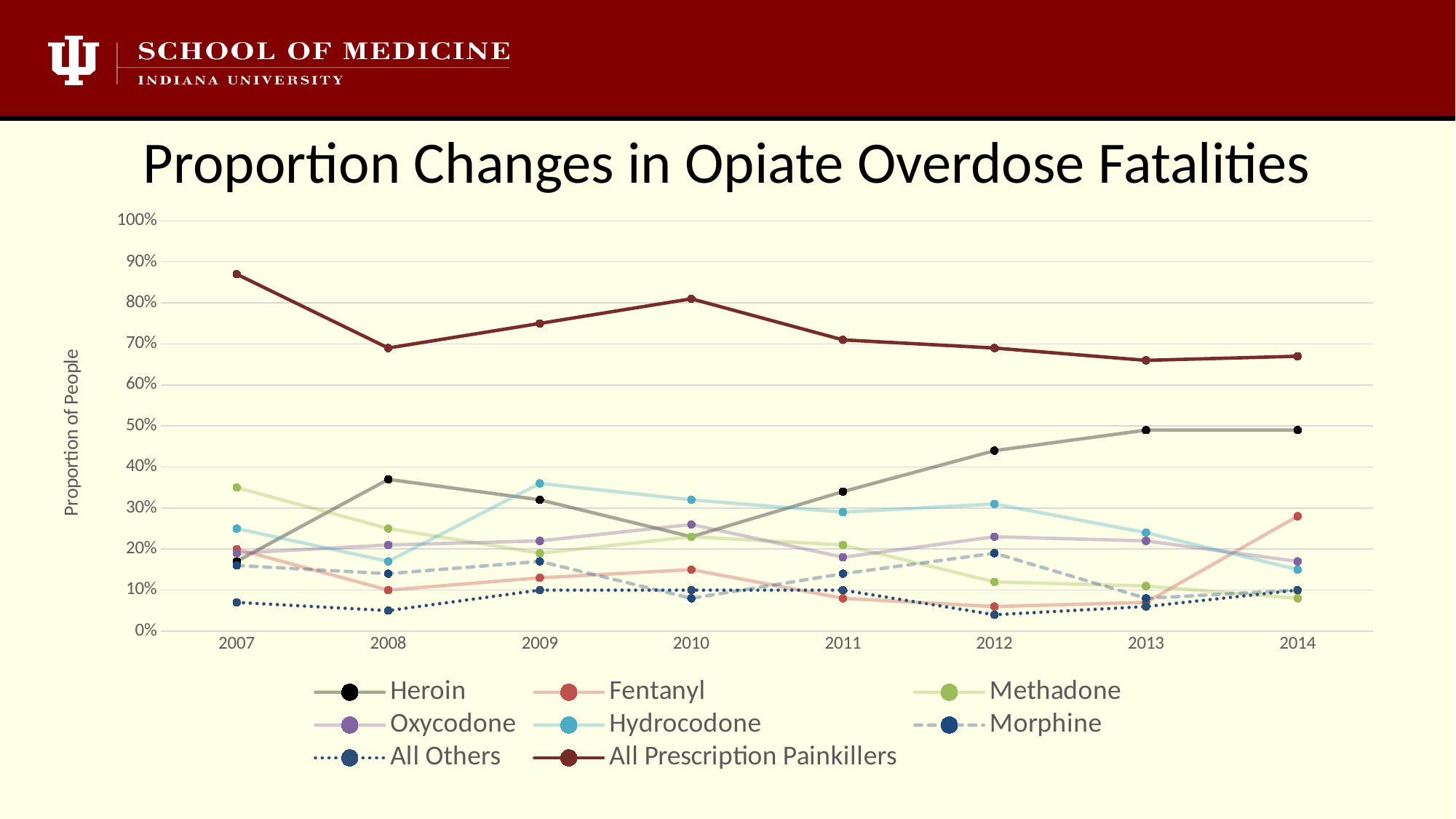
What kind of chart is shown on the slide? line chart How many series does the legend list? 8 In which year is the Heroin series at its lowest? 2007 Which series has the highest value in 2007? All Prescription Painkillers In 2008, which is larger: the value for Heroin or the value for Hydrocodone? Heroin Is the value for All Others in 2008 greater or less than 10%? less How many years are shown on the x axis? 8 Does the Heroin series generally rise or fall from 2007 to 2014? rise Is the value for Heroin in 2012 greater or less than 40%? greater In which year is the All Prescription Painkillers series at its highest? 2007 Is the value for Hydrocodone in 2009 greater or less than 30%? greater